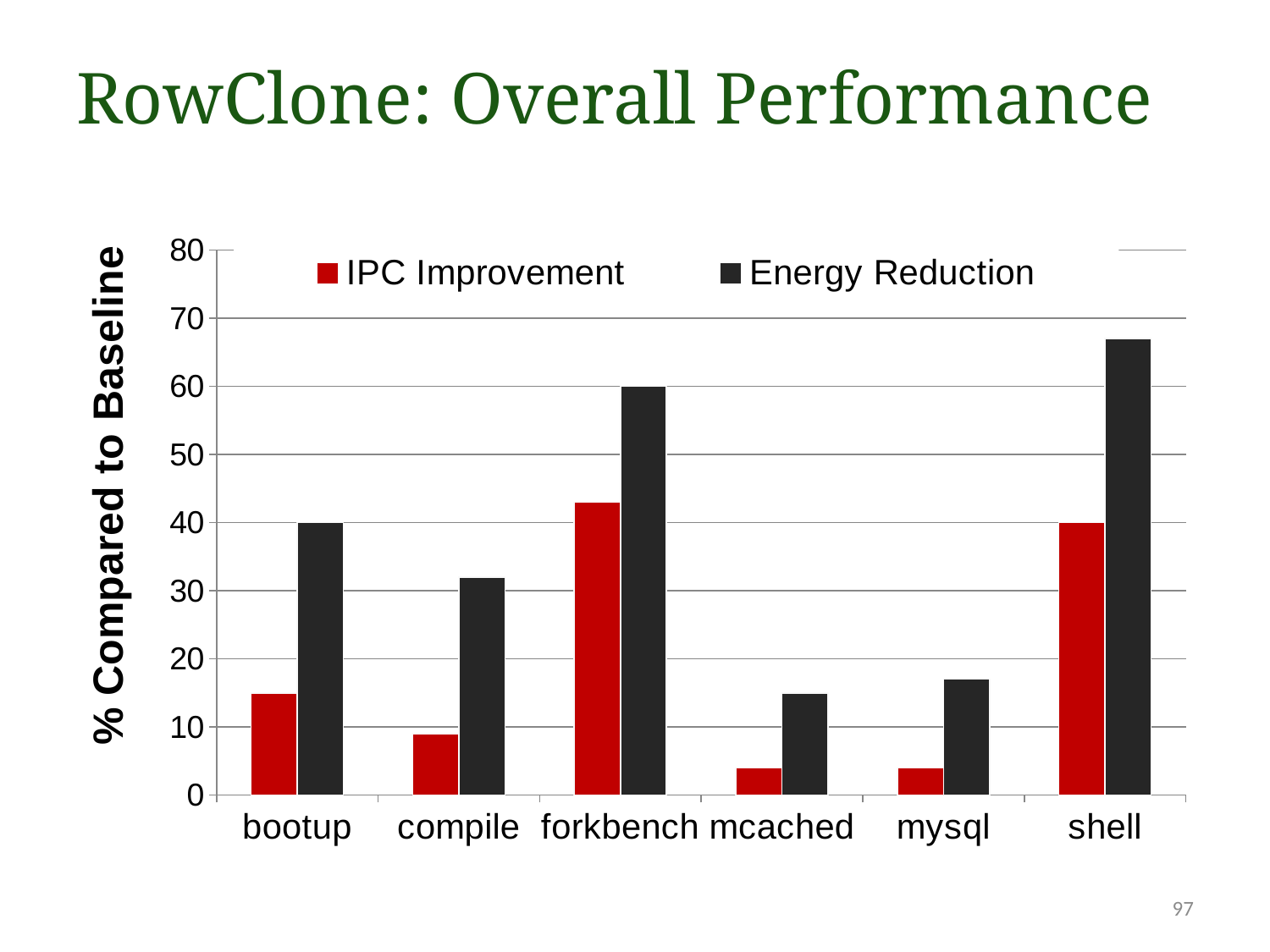
How many benchmark categories are shown on the x axis? 6 Is the IPC Improvement for forkbench greater or less than 40? greater What kind of chart is shown on the slide? bar chart Which benchmark has the highest IPC Improvement? forkbench Is the Energy Reduction for mysql greater or less than 20? less For forkbench, which is larger: IPC Improvement or Energy Reduction? Energy Reduction Is the Energy Reduction for shell greater or less than 60? greater How many series does the legend list? 2 Which benchmark has the highest Energy Reduction? shell Which has the larger Energy Reduction: bootup or compile? bootup What is the title of the y axis? % Compared to Baseline